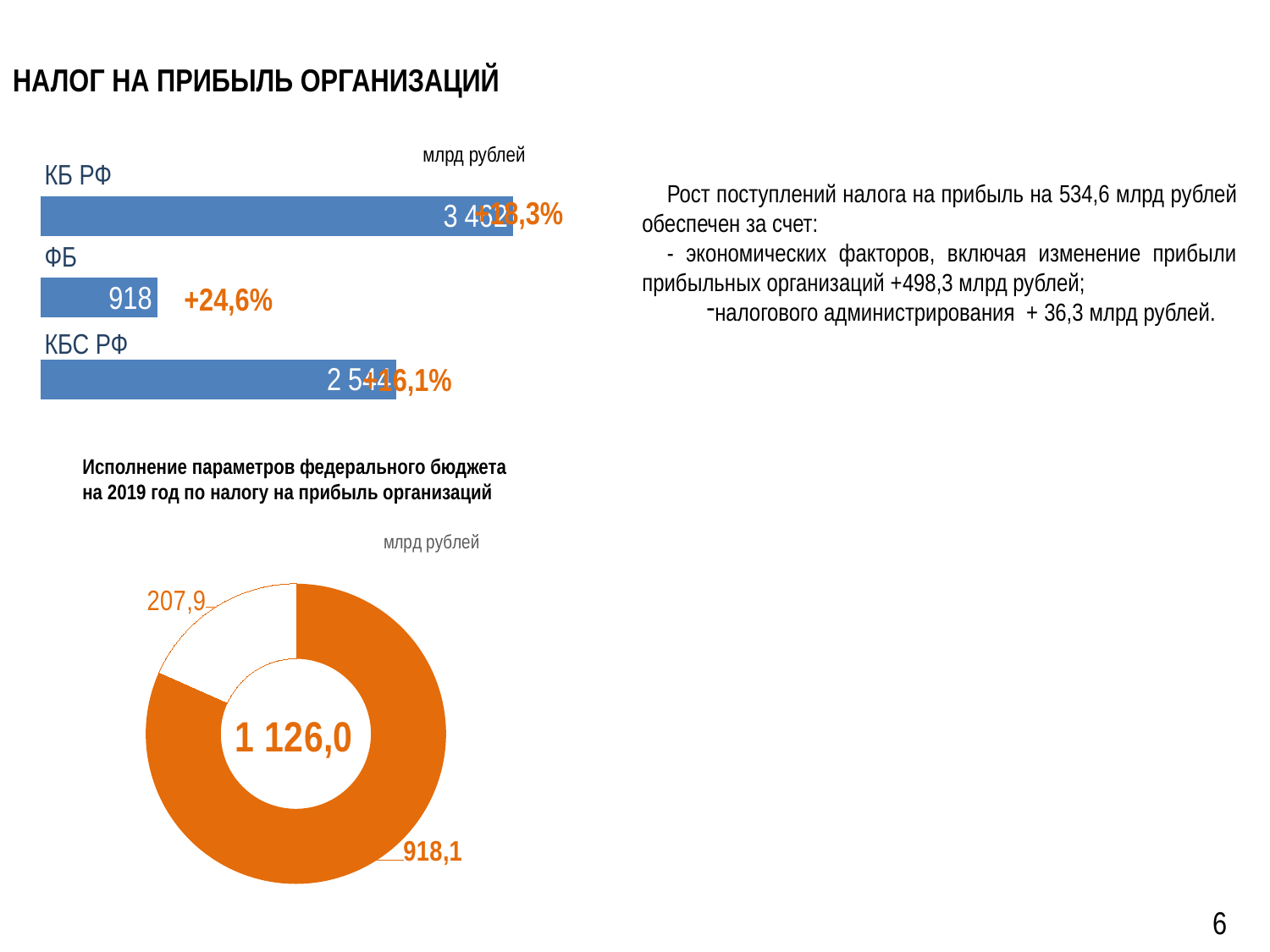
In the top bar chart, what growth percentage is shown for КБС РФ? +16,1% In the top bar chart, what growth percentage is shown next to ФБ? +24,6% How many categories does the top bar chart show? 3 What kind of chart is the top-left chart with КБ РФ, ФБ and КБС РФ? bar chart In the top bar chart, which is larger: КБС РФ or ФБ? КБС РФ In the top bar chart, which category has the shortest bar? ФБ In the bottom donut chart, what is the value of the smaller slice? 207,9 What kind of chart is the bottom chart titled 'Исполнение параметров федерального бюджета на 2019 год по налогу на прибыль организаций'? donut (pie) chart What total value is printed in the centre of the bottom donut chart? 1 126,0 In the bottom donut chart, what is the value of the larger slice? 918,1 In the top bar chart, which category has the longest bar? КБ РФ In the top bar chart, what is the value for ФБ? 918